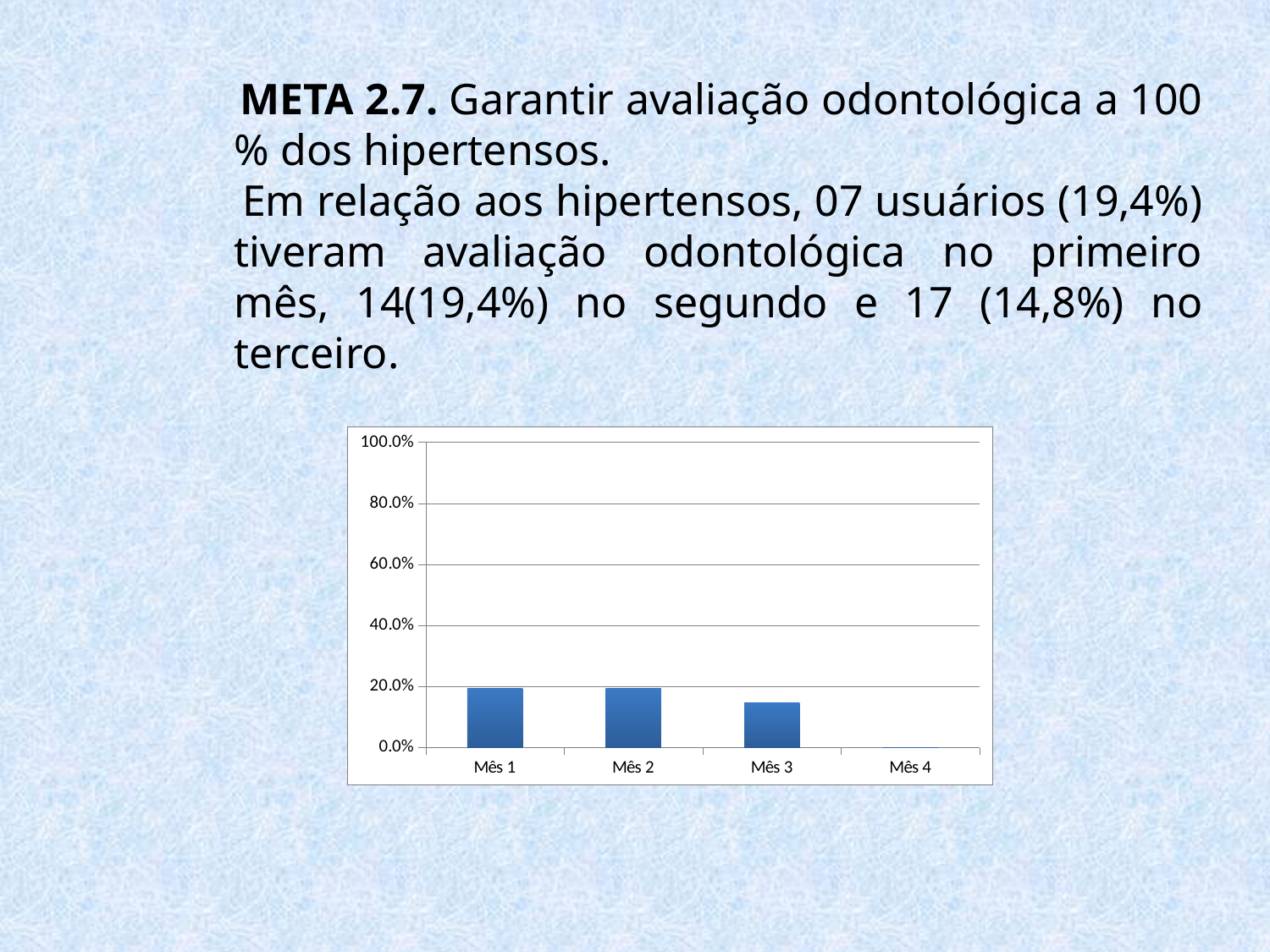
How many categories are shown on the x axis of the chart? 4 Is the value for Mês 3 greater or less than 20.0%? less Which is larger, the value for Mês 2 or the value for Mês 3? Mês 2 What kind of chart is shown on the slide? bar chart What is the highest value shown on the y axis of the chart? 100.0% Which category on the x axis has no visible bar? Mês 4 Do the values rise or fall from Mês 2 to Mês 3? fall Among Mês 1, Mês 2 and Mês 3, which has the lowest bar? Mês 3 Which is larger, the value for Mês 1 or the value for Mês 3? Mês 1 Is the value for Mês 2 greater or less than 60.0%? less Is the value for Mês 1 greater or less than 40.0%? less